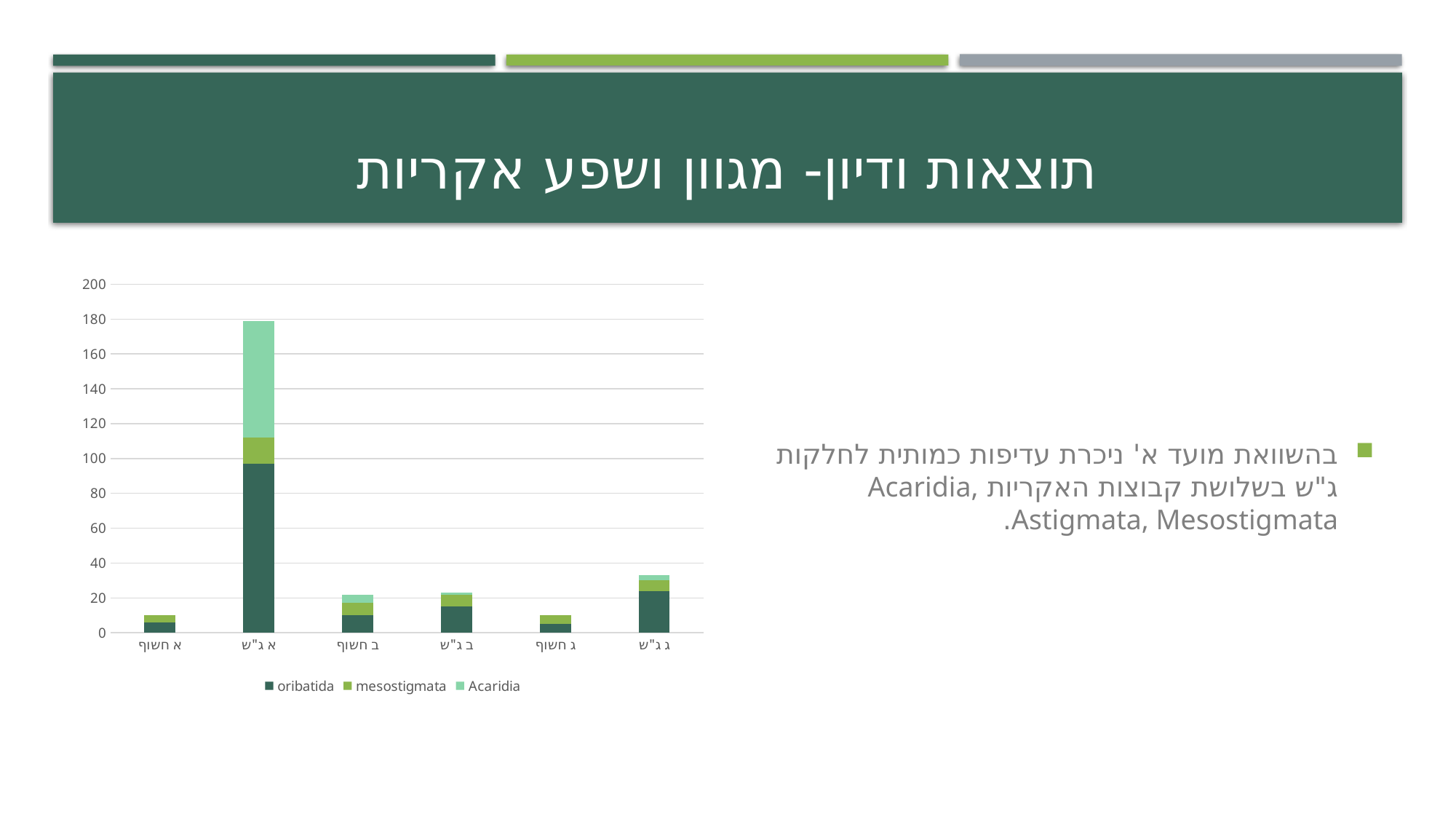
Is the total stacked value for א חשוף greater or less than 20? less What kind of chart is shown on the slide? stacked bar chart Is the oribatida value for א ג"ש greater or less than 80? greater Which series are listed in the chart's legend? oribatida, mesostigmata, Acaridia How many series does the chart's legend list? 3 Is the total stacked value for ג ג"ש greater or less than 40? less Which has the larger total stacked bar, ג חשוף or ג ג"ש? ג ג"ש Which category has the tallest stacked bar? א ג"ש How many categories are shown on the x axis of the chart? 6 Which has the larger total stacked bar, א ג"ש or ב ג"ש? א ג"ש